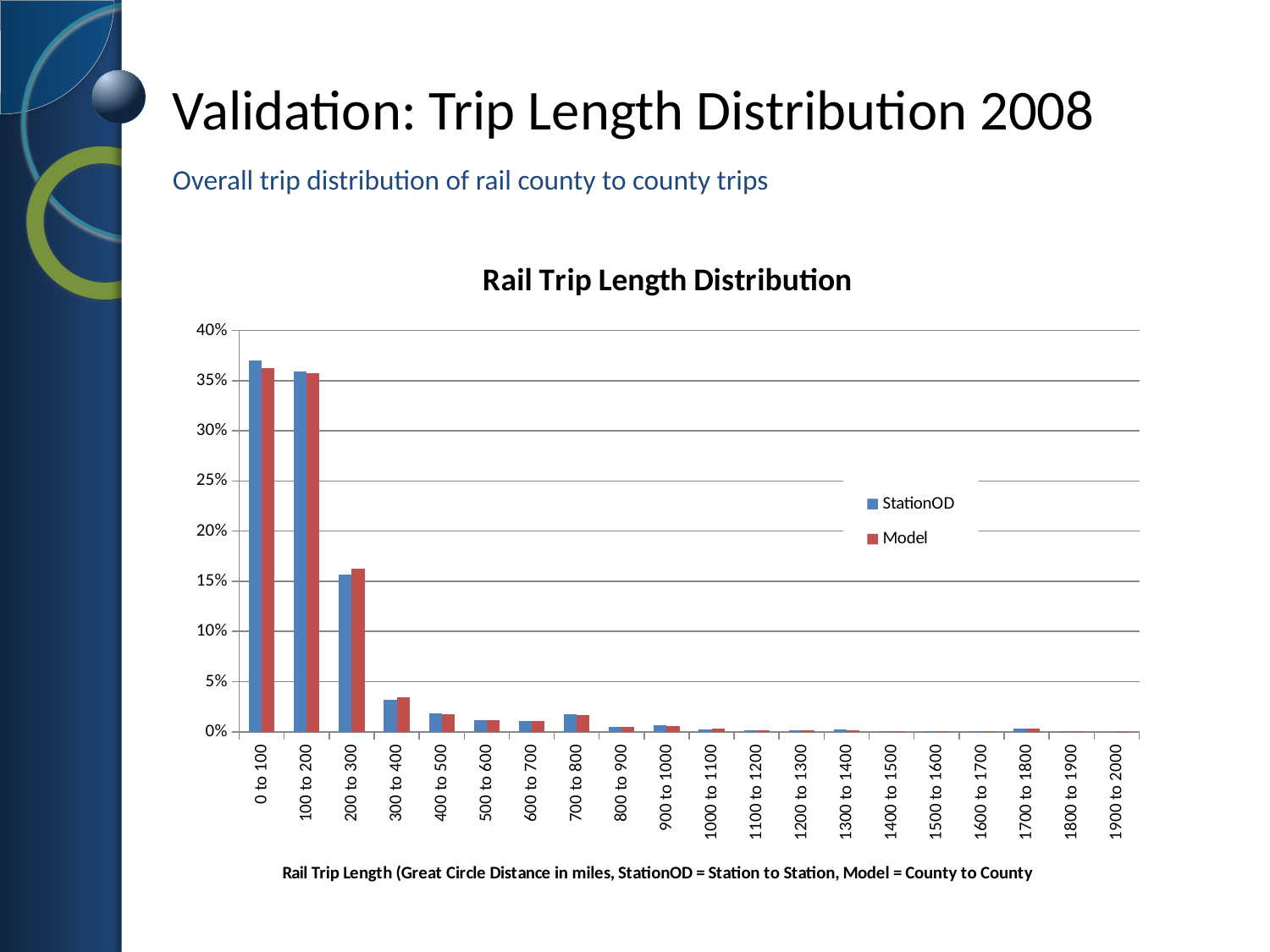
How many trip length categories are shown on the x axis? 20 How many series does the legend list? 2 For the 200 to 300 category, which series has the larger value, StationOD or Model? Model Which series is shown in red in the legend? Model What is the title of the chart? Rail Trip Length Distribution Do the values generally rise or fall as trip length increases along the x axis? Fall Is the StationOD value for 0 to 100 greater or less than 40%? less Is the Model value for 200 to 300 greater or less than 15%? greater Is the StationOD value for 0 to 100 greater or less than 35%? greater What kind of chart is shown on the slide? Bar chart Which trip length category has the tallest bar in the chart? 0 to 100